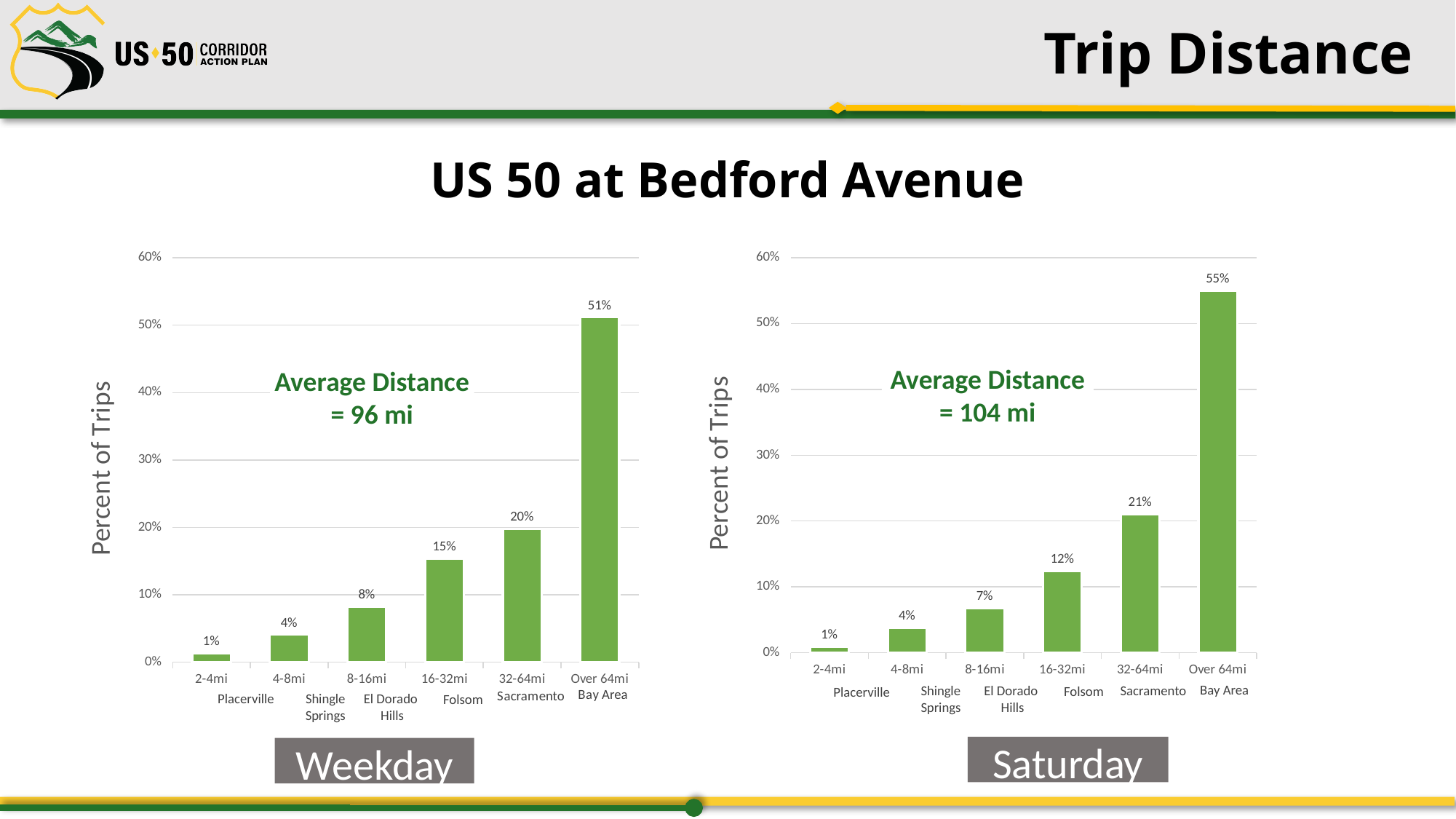
How many distance categories are shown in the Weekday chart? 6 In the Saturday chart, what percent of trips are 16-32mi (Folsom)? 12% Which is larger: the Over 64mi value in the Weekday chart or in the Saturday chart? Saturday In the Weekday chart, which distance category has the lowest percent of trips? 2-4mi In the Weekday chart, do the values rise or fall as distance increases along the x axis? rise In the Weekday chart, what percent of trips are Over 64mi (Bay Area)? 51% What is the average distance shown on the Saturday chart? 104 mi What is the y-axis label on the Weekday chart? Percent of Trips What kind of chart is the Saturday chart? bar chart In the Saturday chart, is the value for 32-64mi greater or less than 20%? greater In the Saturday chart, which distance category has the highest percent of trips? Over 64mi In the Weekday chart, what is the difference between the 32-64mi and 16-32mi values? 5%